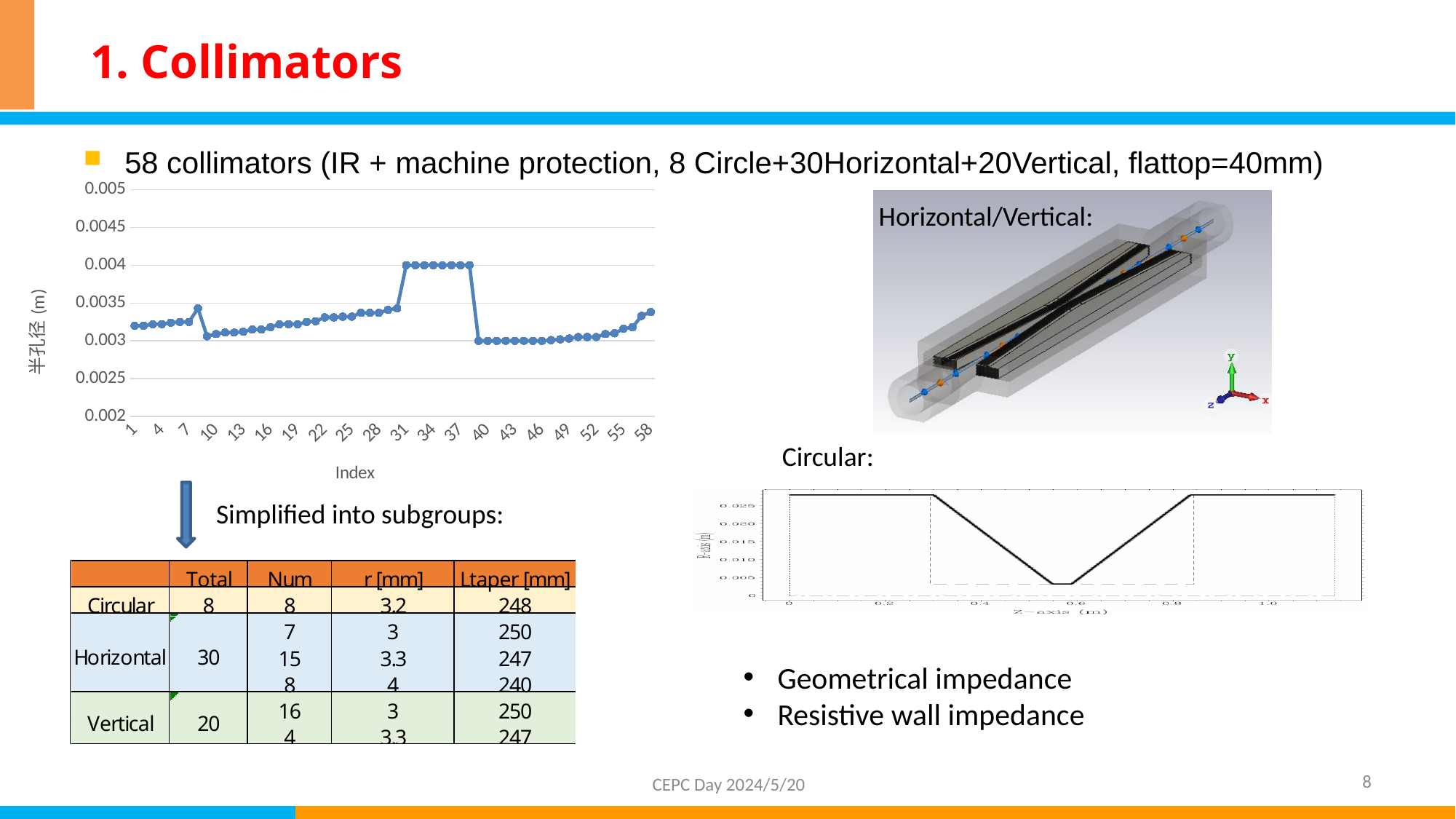
In the left line chart, is the value at index 1 greater or less than 0.003? greater In the left line chart, what is the label of the y axis? 半孔径 (m) In the left line chart, which has the larger value, index 34 or index 43? index 34 In the left line chart, do the values rise or fall from index 10 to index 30? rise What kind of chart is the chart on the left of the slide (half aperture vs Index)? line chart In the left line chart, is the value at index 43 greater or less than 0.0035? less In the left line chart, what is the highest value plotted? 0.004 In the left line chart, is the value at index 34 greater or less than 0.0035? greater In the left line chart, what is the lowest value plotted? 0.003 In the left line chart, what is the value at index 34? 0.004 In the left line chart, what is the title of the x axis? Index In the left line chart, how many data points are plotted? 58